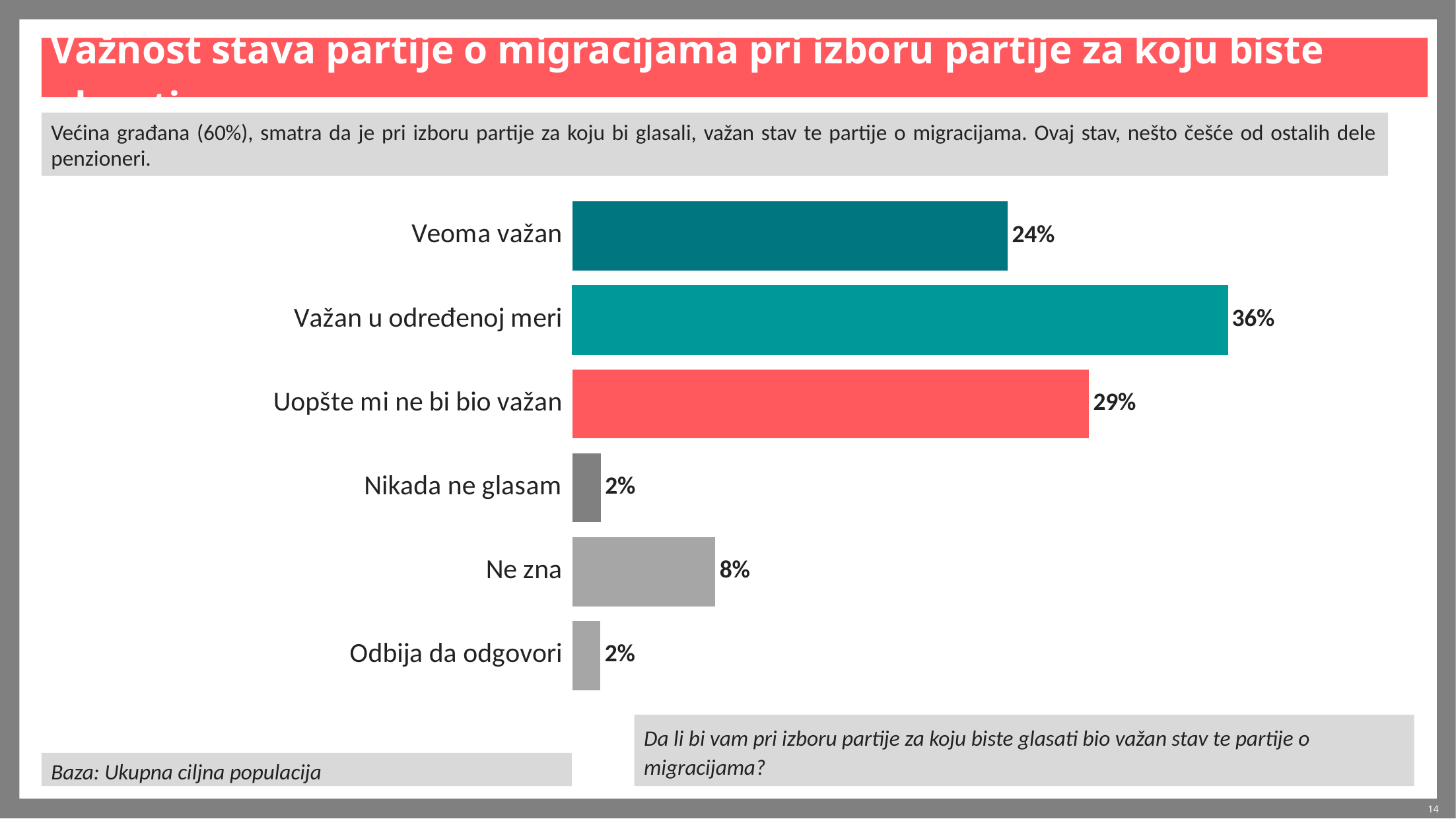
What colour is the bar for "Uopšte mi ne bi bio važan"? Red What is the difference between "Uopšte mi ne bi bio važan" and "Ne zna"? 21% Which category has the highest value? Važan u određenoj meri What is the value for "Uopšte mi ne bi bio važan"? 29% What is the value for "Ne zna"? 8% Which is larger, "Uopšte mi ne bi bio važan" or "Veoma važan"? Uopšte mi ne bi bio važan What kind of chart is shown on the slide? Bar chart What is the difference between "Važan u određenoj meri" and "Veoma važan"? 12% What is the value for "Nikada ne glasam"? 2% What is the value for "Važan u određenoj meri"? 36% What is the value for "Veoma važan"? 24% How many categories are shown in the chart? 6